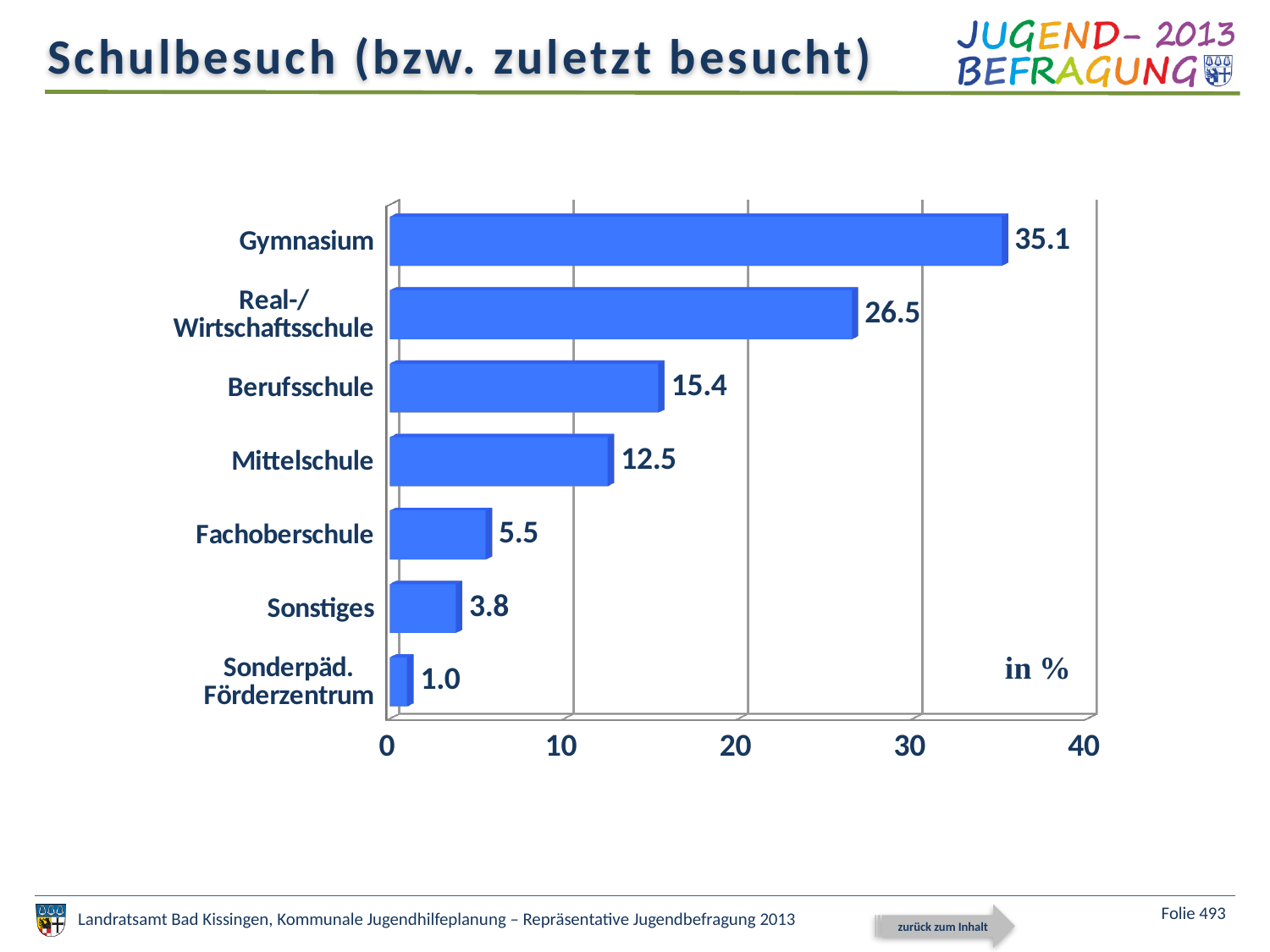
Which category has the lowest value? Sonderpäd. Förderzentrum Which is larger, the value for Mittelschule or the value for Fachoberschule? Mittelschule What is the difference between the values for Gymnasium and Real-/Wirtschaftsschule? 8.6 Which category has the highest value? Gymnasium What is the difference between the values for Berufsschule and Mittelschule? 2.9 What kind of chart is shown on the slide? bar chart What is the value for Berufsschule? 15.4 What is the value for Gymnasium? 35.1 Is the value for Real-/Wirtschaftsschule greater or less than 30? less How many categories are shown in the chart? 7 What unit is indicated on the chart? in % What is the value for Fachoberschule? 5.5